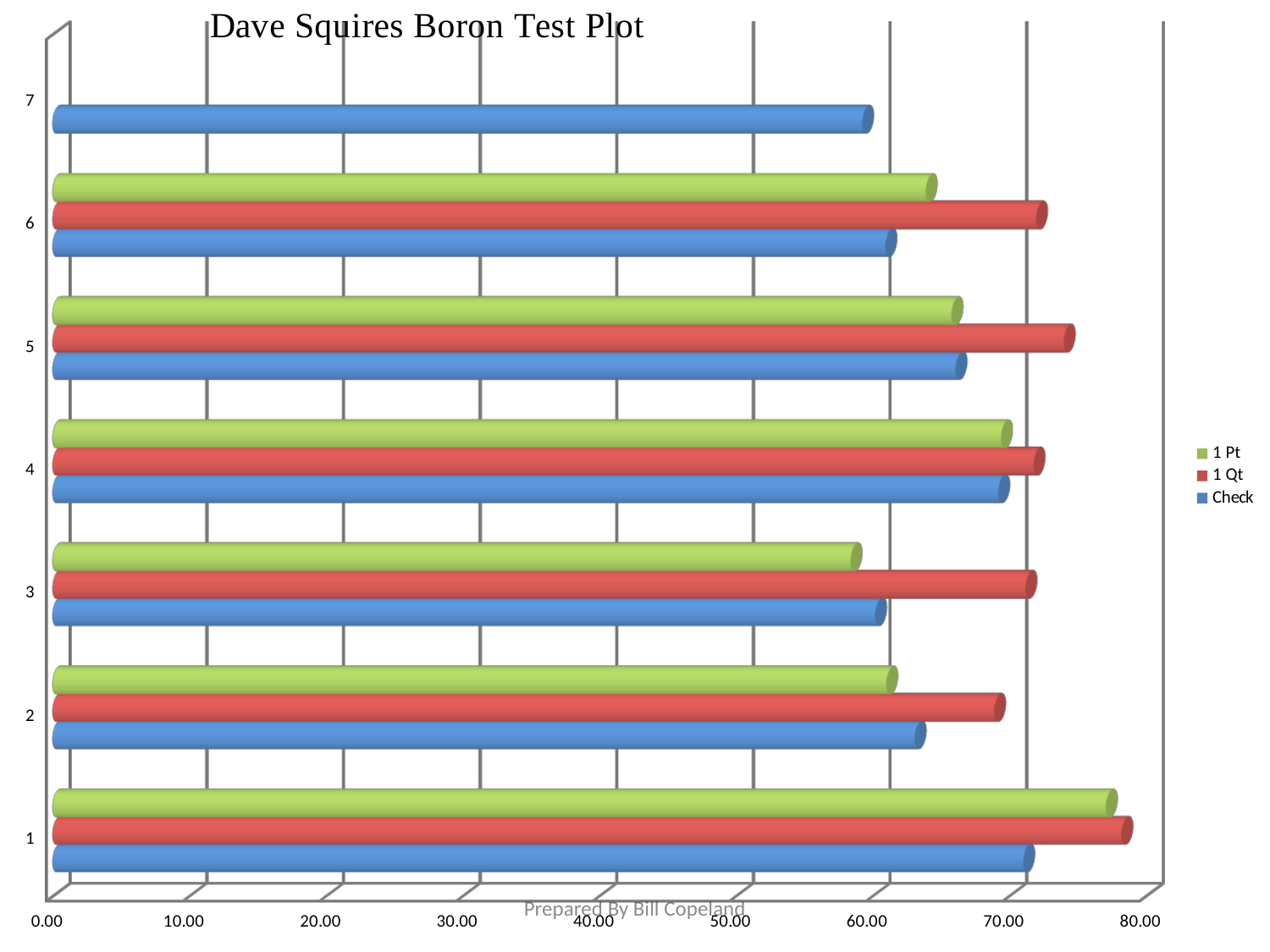
Is the 1 Qt value for category 5 greater or less than 70.00? greater How many series does the legend list? 3 Is the Check value for category 2 greater or less than 60.00? greater For category 1, which is larger: the 1 Pt value or the Check value? 1 Pt Which category has the highest 1 Qt value? 1 How many categories are shown on the vertical axis? 7 Is the 1 Pt value for category 3 greater or less than 60.00? less What kind of chart is shown on the slide? Bar chart For category 3, which is larger: the 1 Qt value or the 1 Pt value? 1 Qt Which colour represents the 1 Qt series in the legend? Red What is the title of the chart? Dave Squires Boron Test Plot